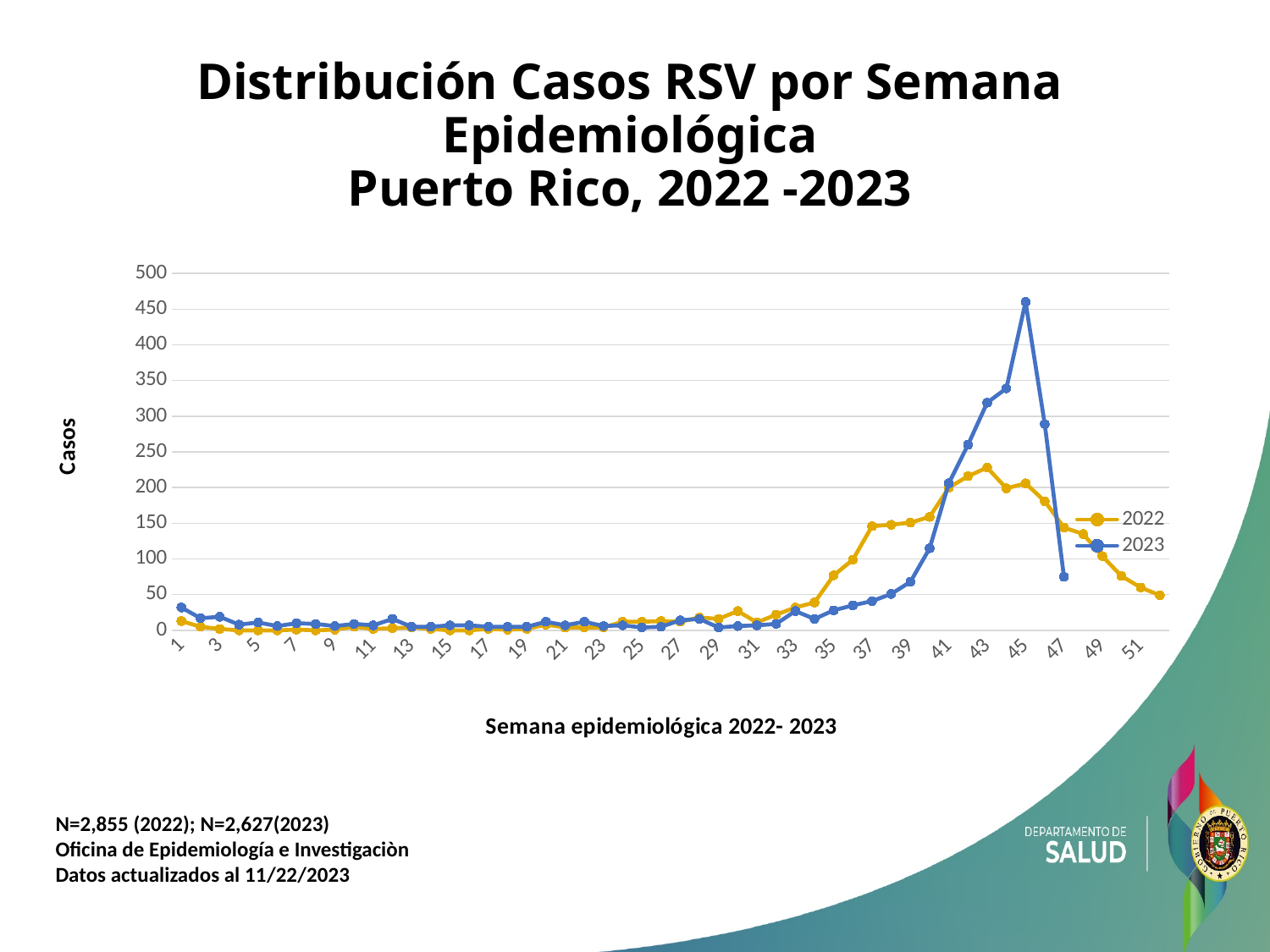
What kind of chart is shown on the slide? line chart In which week does the 2022 series reach its highest value? 43 What is the label on the vertical axis? Casos In which week does the 2023 series reach its highest value? 45 How many series does the legend list? 2 What are the two series named in the legend? 2022 and 2023 Does the 2023 series rise or fall between week 39 and week 45? rise Is the value for 2023 in week 45 greater or less than 400? greater Is the value for 2023 in week 47 greater or less than 100? less Which series has the higher value in week 37, 2022 or 2023? 2022 Is the value for 2022 in week 37 greater or less than 100? greater